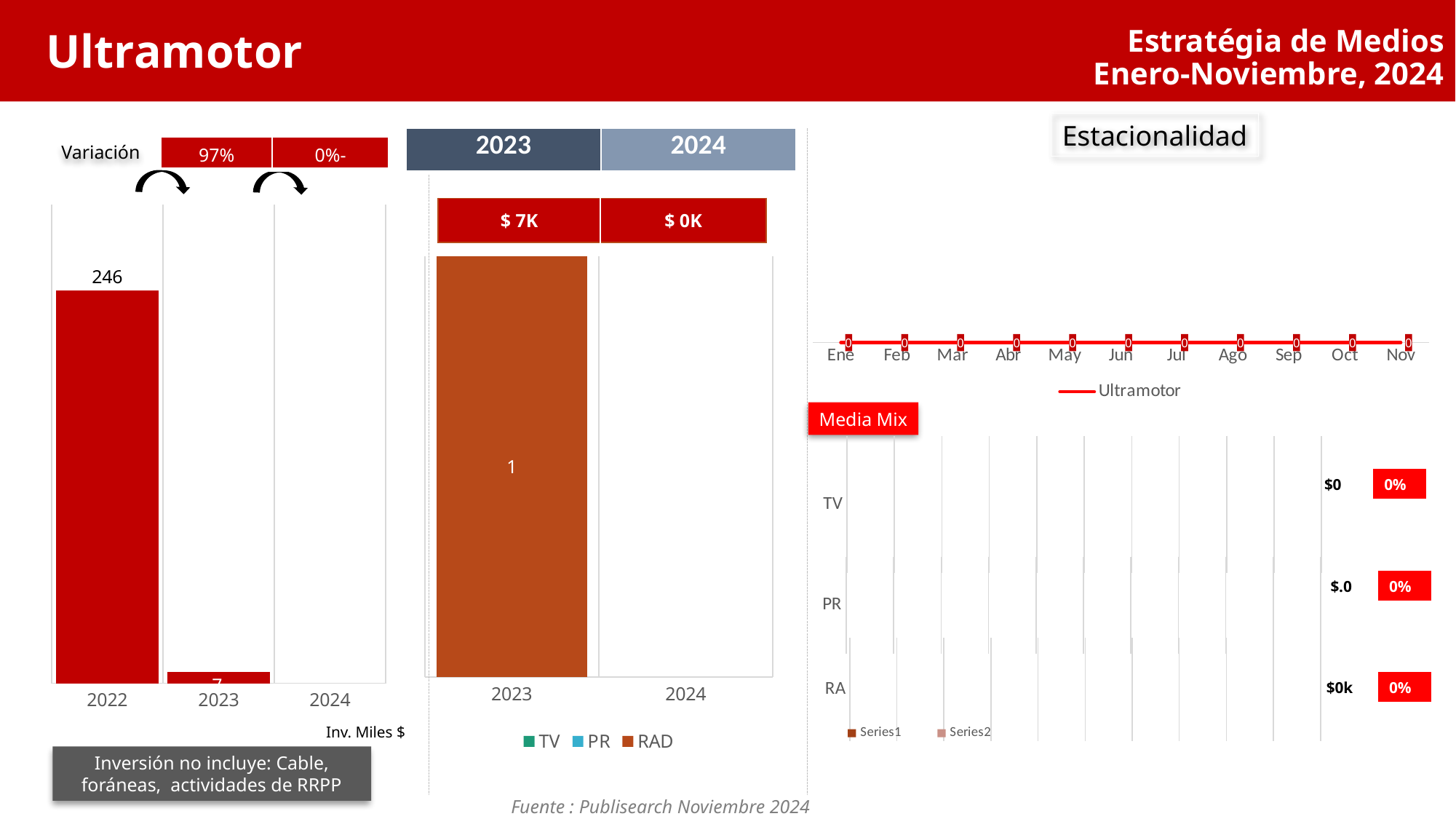
In the middle chart (2023 vs 2024 with TV, PR, RAD), how many series does the legend list? 3 In the left bar chart (Inv. Miles $), which year has the highest value? 2022 In the Media Mix chart, what percentage is shown for TV? 0% What kind of chart is the Estacionalidad chart? line chart In the left bar chart (Inv. Miles $), do the values rise or fall from 2022 to 2024? fall In the left bar chart (Inv. Miles $), what is the difference between the values for 2022 and 2023? 239 What kind of chart is the left chart showing 2022, 2023 and 2024? bar chart In the left bar chart (Inv. Miles $), what is the value for 2023? 7 In the middle chart (2023 vs 2024), what are the legend entries? TV, PR, RAD In the left bar chart (Inv. Miles $), how many years are shown on the x axis? 3 In the left bar chart (Inv. Miles $), what is the value for 2022? 246 In the Estacionalidad chart, how many months are shown on the x axis? 11